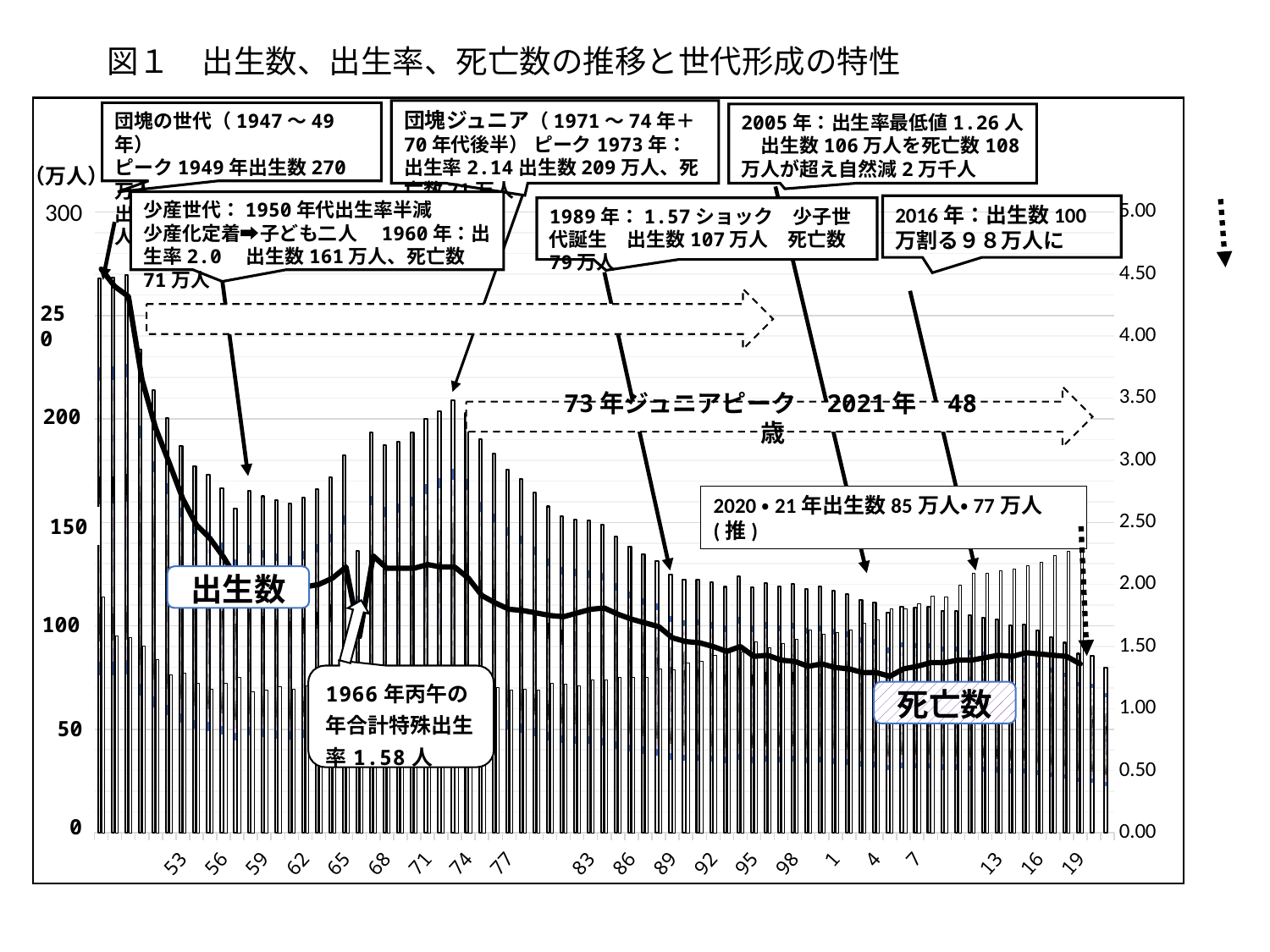
According to the annotation, what was the number of births (出生数) at the 1949 peak? 270万人 Which year had more births: 1949 or 1973? 1949 Is the number of births (出生数) in 1973 greater or less than 200 on the left axis? greater Overall, do the births (出生数) bars rise or fall from 1949 to 2021? fall What kind of chart is this? Bar chart combined with a line chart What is the difference between births (161万人) and deaths (71万人) in 1960, as given in the annotations? 90万人 What is the title of the chart? 図１ 出生数、出生率、死亡数の推移と世代形成の特性 According to the annotation, what was the birth rate (出生率) in 2005? 1.26人 According to the annotation, what was the number of deaths (死亡数) in 1989? 79万人 According to the annotation, what was the number of births (出生数) in 1973? 209万人 Is the birth rate (出生率) line in 2005 greater or less than 1.50 on the right axis? less What unit is shown for the left vertical axis? 万人